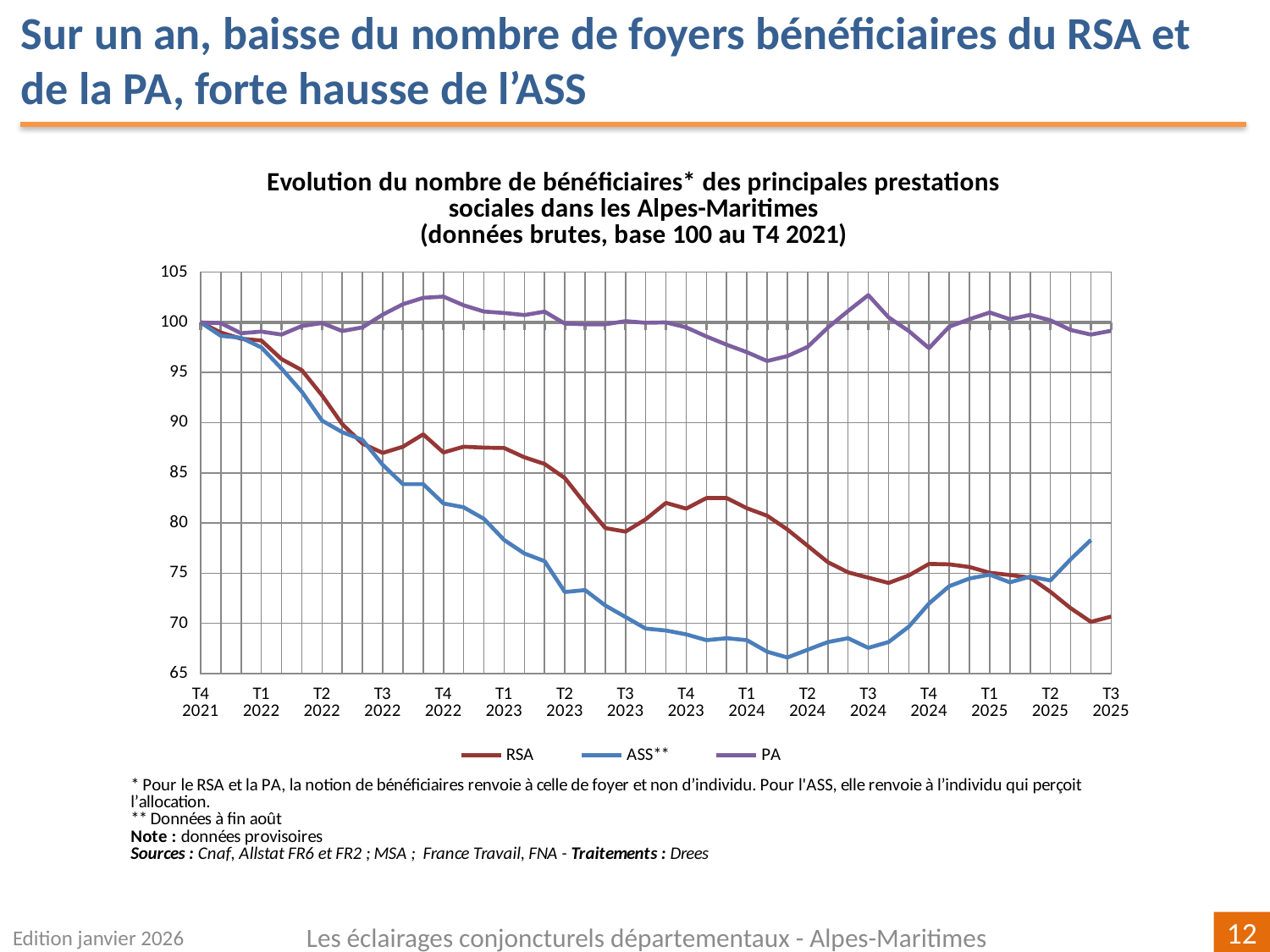
Does the RSA series rise or fall overall from T4 2021 to T3 2025? fall How many quarters are labelled on the x axis? 16 Is the value for ASS** at T2 2024 greater or less than 70? less How many series does the legend list? 3 What is the value of each series at T4 2021, the base period? 100 Which series has the lowest value at T3 2025? RSA Which colour is used for the PA series? purple What kind of chart is shown on the slide? line chart Is the value for PA at T1 2024 greater or less than 100? less Is the value for RSA at T4 2022 greater or less than 90? less